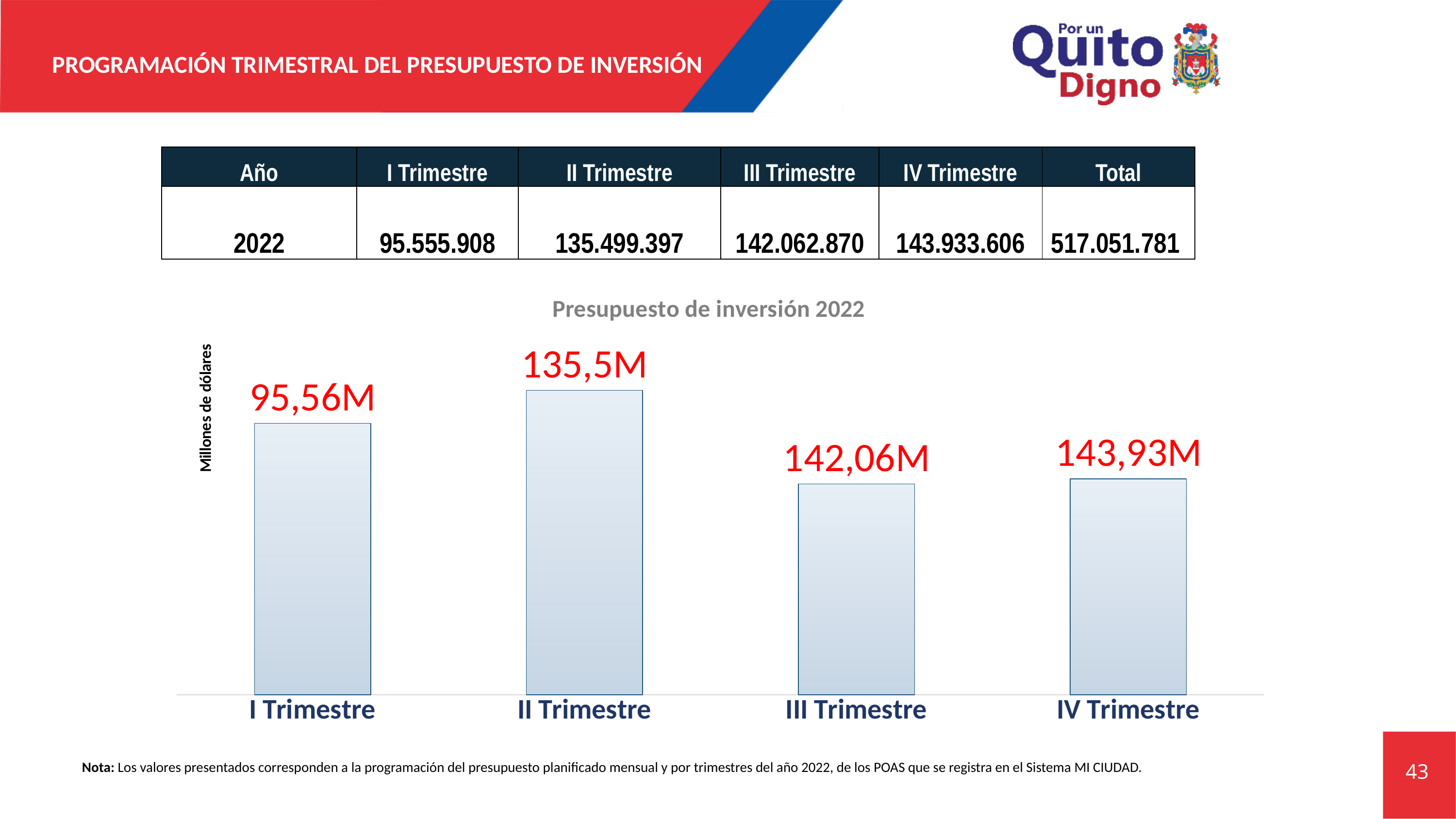
Which is larger, the value for II Trimestre or the value for III Trimestre? III Trimestre What is the difference between the values for IV Trimestre and III Trimestre? 1,87M Do the values rise or fall from I Trimestre to IV Trimestre? Rise What is the value for IV Trimestre in the chart? 143,93M What kind of chart is shown on the slide? Bar chart How many bars are shown in the chart? 4 What is the value for II Trimestre in the chart? 135,5M What is the value for I Trimestre in the chart? 95,56M What is the difference between the values for II Trimestre and I Trimestre? 39,94M What is the value for III Trimestre in the chart? 142,06M Which quarter has the highest value in the chart? IV Trimestre Which quarter has the lowest value in the chart? I Trimestre